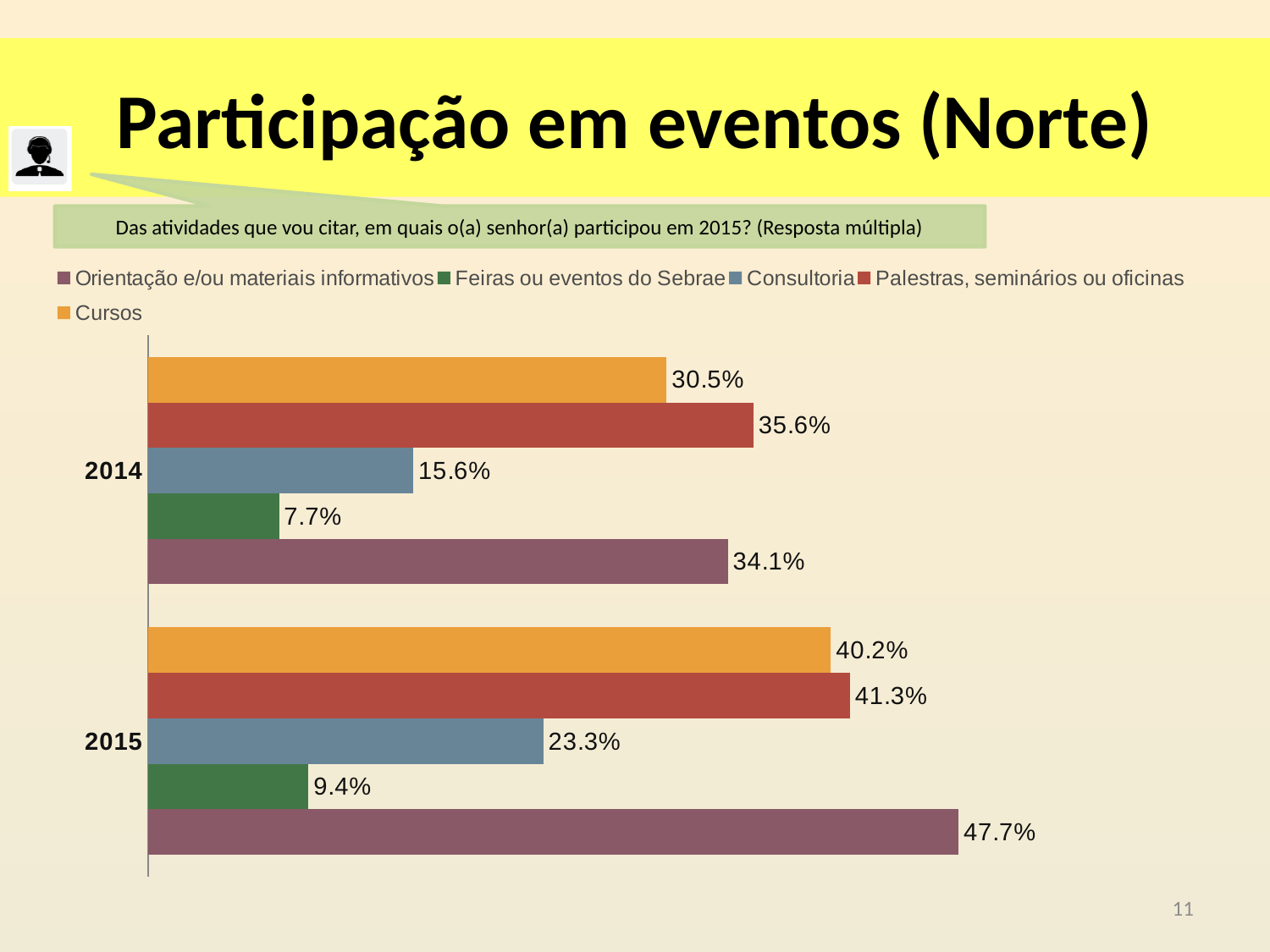
How many year categories are shown on the chart? 2 What is the value for Feiras ou eventos do Sebrae in 2015? 9.4% What is the value for Cursos in 2015? 40.2% Which is larger in 2014: Palestras, seminários ou oficinas or Cursos? Palestras, seminários ou oficinas Did the value for Consultoria rise or fall from 2014 to 2015? Rise What is the difference between the Orientação e/ou materiais informativos values for 2015 and 2014? 13.6% Which series has the lowest value in 2014? Feiras ou eventos do Sebrae Which colour represents Cursos in the legend? Orange Which series has the highest value in 2015? Orientação e/ou materiais informativos How many series does the legend list? 5 What kind of chart is shown on the slide? Bar chart What is the value for Consultoria in 2014? 15.6%